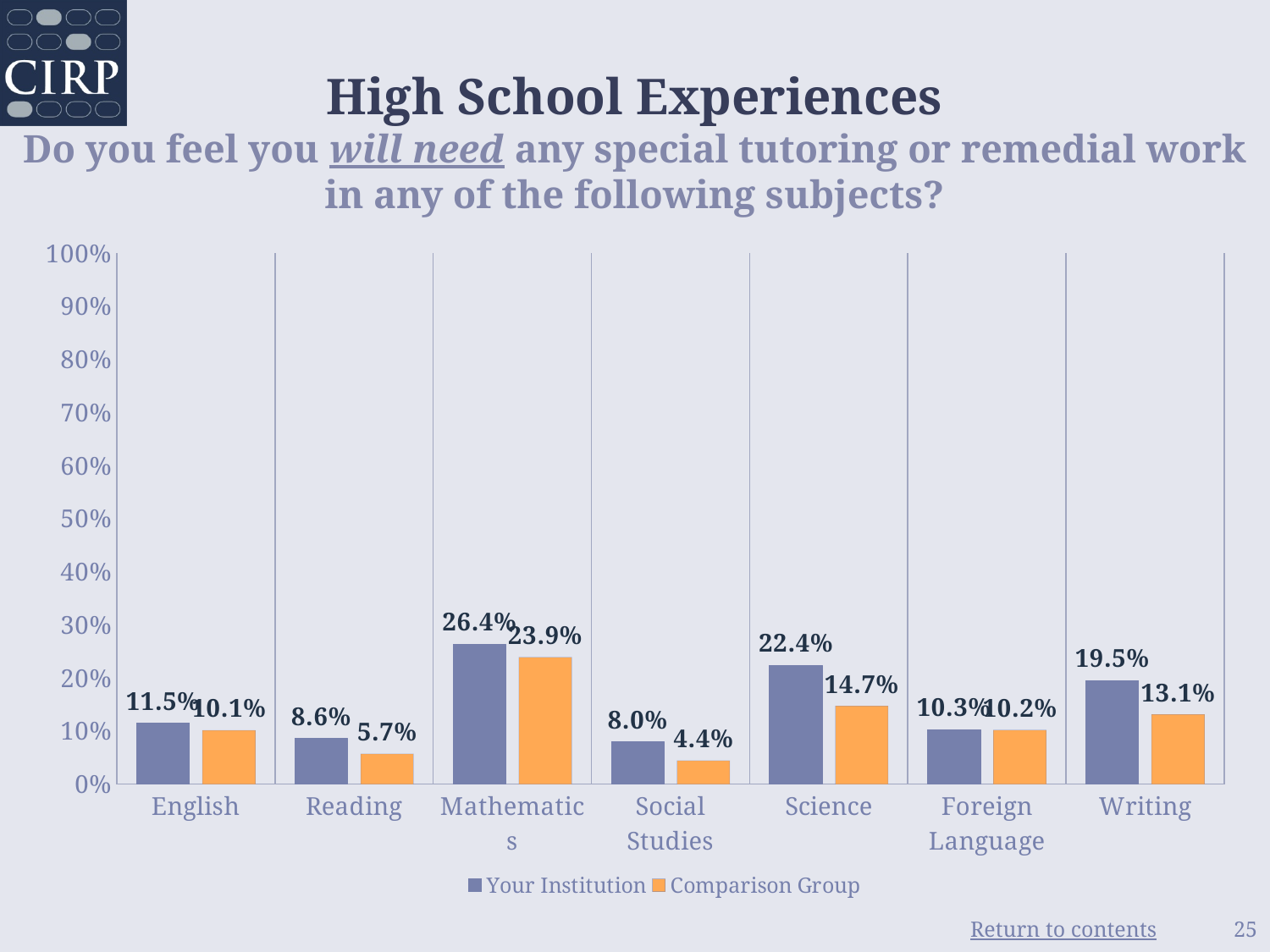
How many series does the legend list? 2 What is the difference between Your Institution and the Comparison Group in Science? 7.7% Which is larger in Reading: Your Institution or the Comparison Group? Your Institution What is the difference between Your Institution and the Comparison Group in Writing? 6.4% What is the value for Your Institution in Mathematics? 26.4% How many subjects are shown on the x axis? 7 What is the value for the Comparison Group in Science? 14.7% Which subject has the lowest value for the Comparison Group? Social Studies What is the value for the Comparison Group in Reading? 5.7% What kind of chart is shown on the slide? Bar chart What is the value for Your Institution in Social Studies? 8.0% Which subject has the highest value for Your Institution? Mathematics